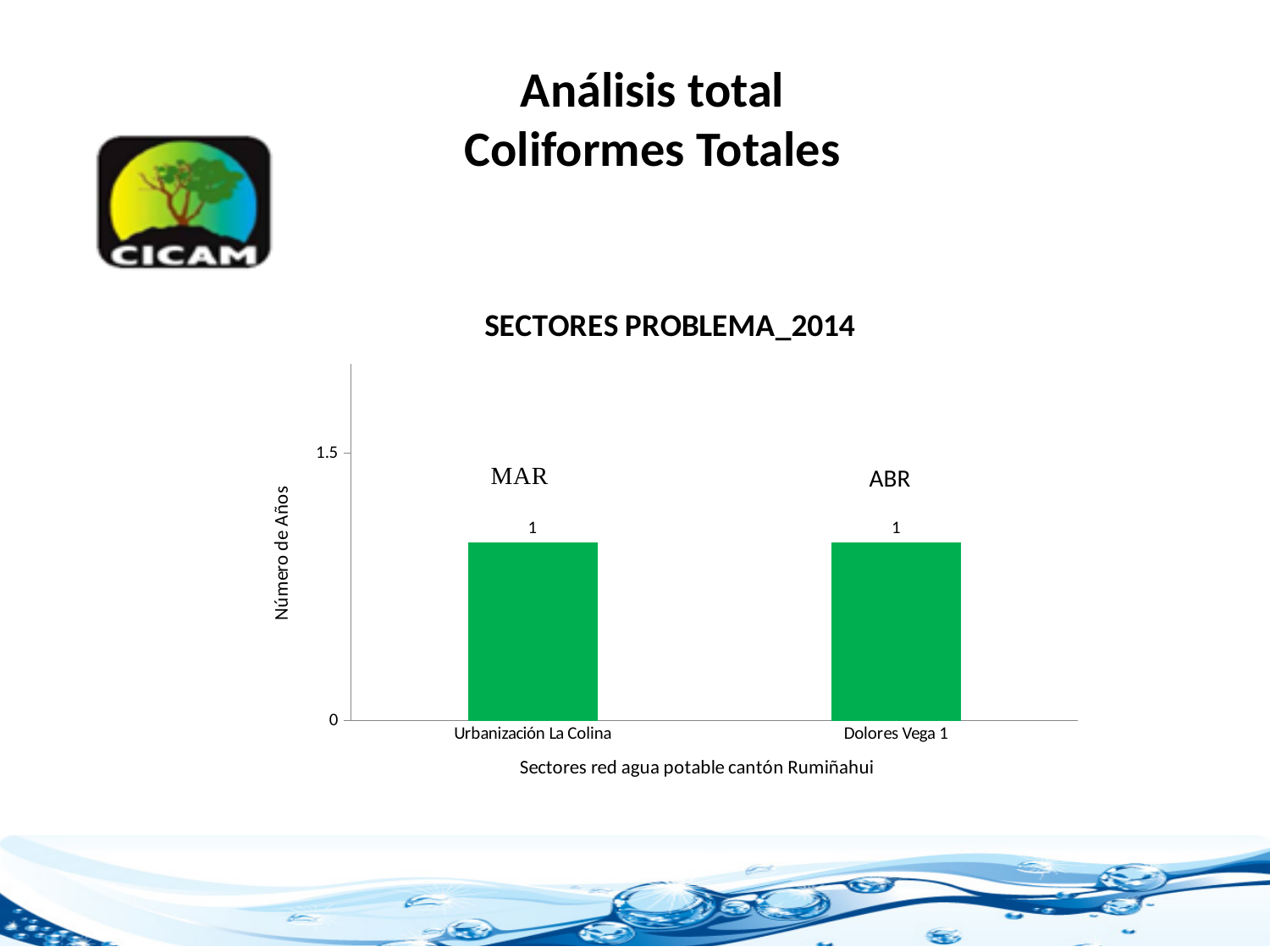
Is the value for Urbanización La Colina greater or less than 1.5? less What is the title of the chart on the slide? SECTORES PROBLEMA_2014 What kind of chart is shown on the slide? bar chart What is the label of the vertical axis of the chart? Número de Años What is the value for Dolores Vega 1 in the SECTORES PROBLEMA_2014 chart? 1 What is the difference between the values for Urbanización La Colina and Dolores Vega 1? 0 What is the value for Urbanización La Colina in the SECTORES PROBLEMA_2014 chart? 1 Is the value for Urbanización La Colina larger than, smaller than, or equal to the value for Dolores Vega 1? equal Is the value for Dolores Vega 1 greater or less than 1.5? less How many categories are plotted in the SECTORES PROBLEMA_2014 chart? 2